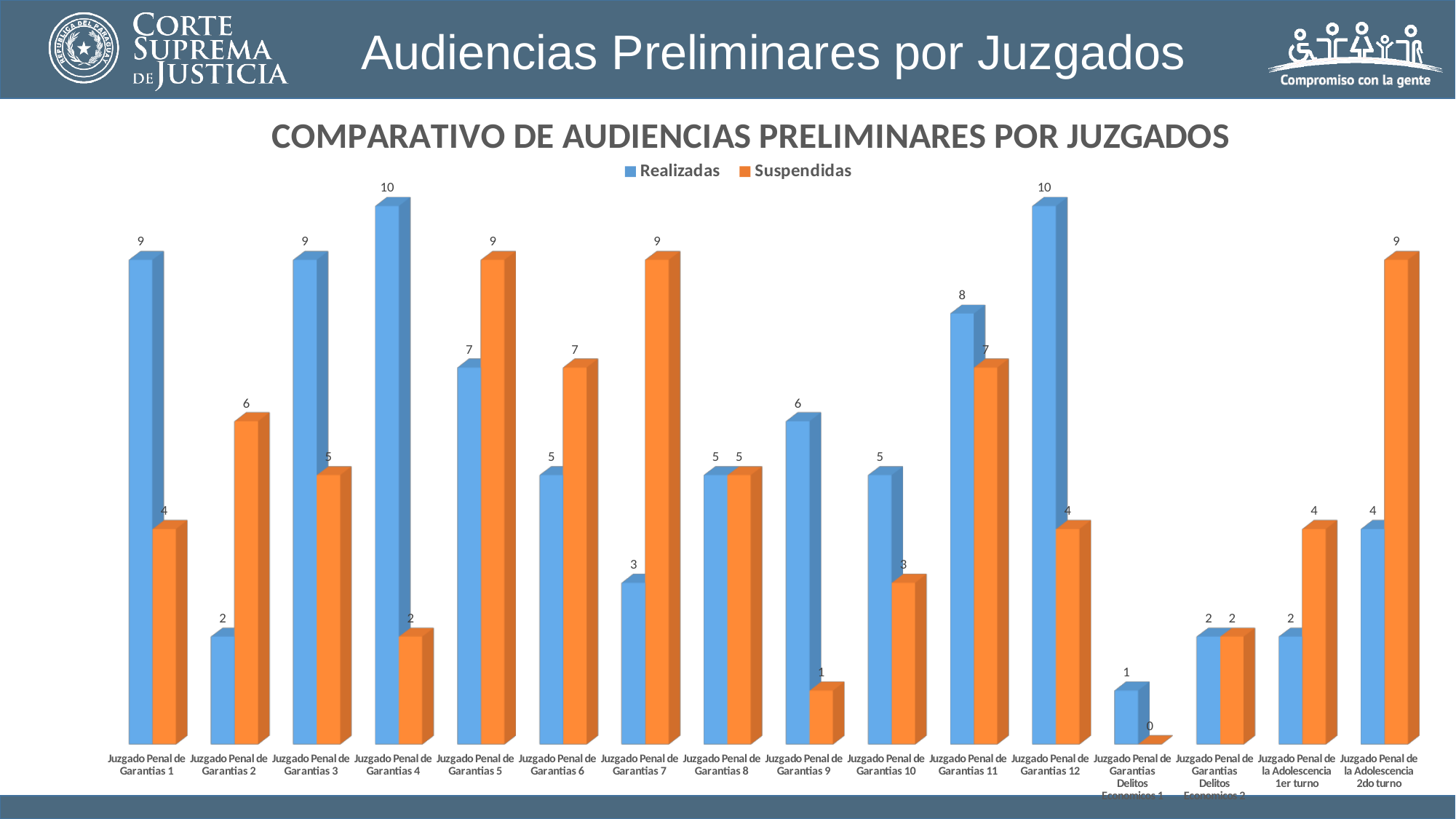
How many series does the legend list? 2 What type of chart is shown on the slide? Bar chart What is the difference between the Realizadas values of Juzgado Penal de Garantias 12 and Juzgado Penal de Garantias 11? 2 Which category has the lowest Realizadas value? Juzgado Penal de Garantias Delitos Economicos 1 How many categories (juzgados) are shown on the x axis? 16 What is the Realizadas value for Juzgado Penal de Garantias 4? 10 What is the Suspendidas value for Juzgado Penal de la Adolescencia 1er turno? 4 For Juzgado Penal de la Adolescencia 2do turno, which is larger, Realizadas or Suspendidas? Suspendidas For Juzgado Penal de Garantias 9, which is larger, Realizadas or Suspendidas? Realizadas What is the difference between Realizadas and Suspendidas for Juzgado Penal de Garantias 2? 4 What is the Suspendidas value for Juzgado Penal de Garantias 7? 9 Which category has the lowest Suspendidas value? Juzgado Penal de Garantias Delitos Economicos 1